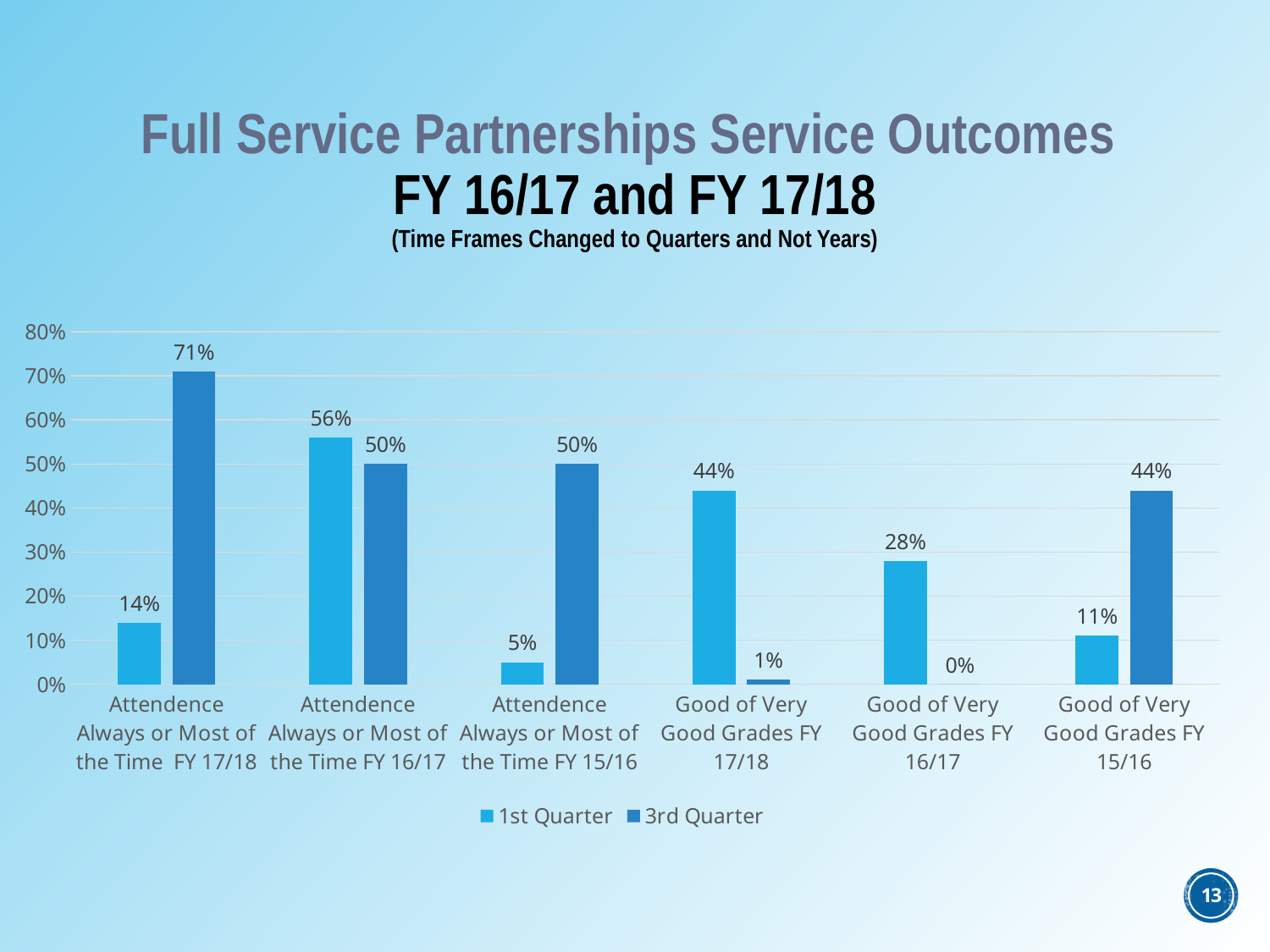
What kind of chart is shown on the slide? Bar chart Which category has the highest 3rd Quarter value? Attendence Always or Most of the Time FY 17/18 How many series does the legend list? 2 What are the two series named in the legend? 1st Quarter and 3rd Quarter Which category has the lowest 3rd Quarter value? Good of Very Good Grades FY 16/17 What is the difference between the 3rd Quarter and 1st Quarter values for Attendence Always or Most of the Time FY 17/18? 57% How many categories are shown on the x axis? 6 Which is larger for Attendence Always or Most of the Time FY 16/17: the 1st Quarter value or the 3rd Quarter value? 1st Quarter What is the 1st Quarter value for Good of Very Good Grades FY 16/17? 28% What is the 3rd Quarter value for Good of Very Good Grades FY 17/18? 1% What is the 3rd Quarter value for Attendence Always or Most of the Time FY 17/18? 71% What is the 1st Quarter value for Attendence Always or Most of the Time FY 17/18? 14%